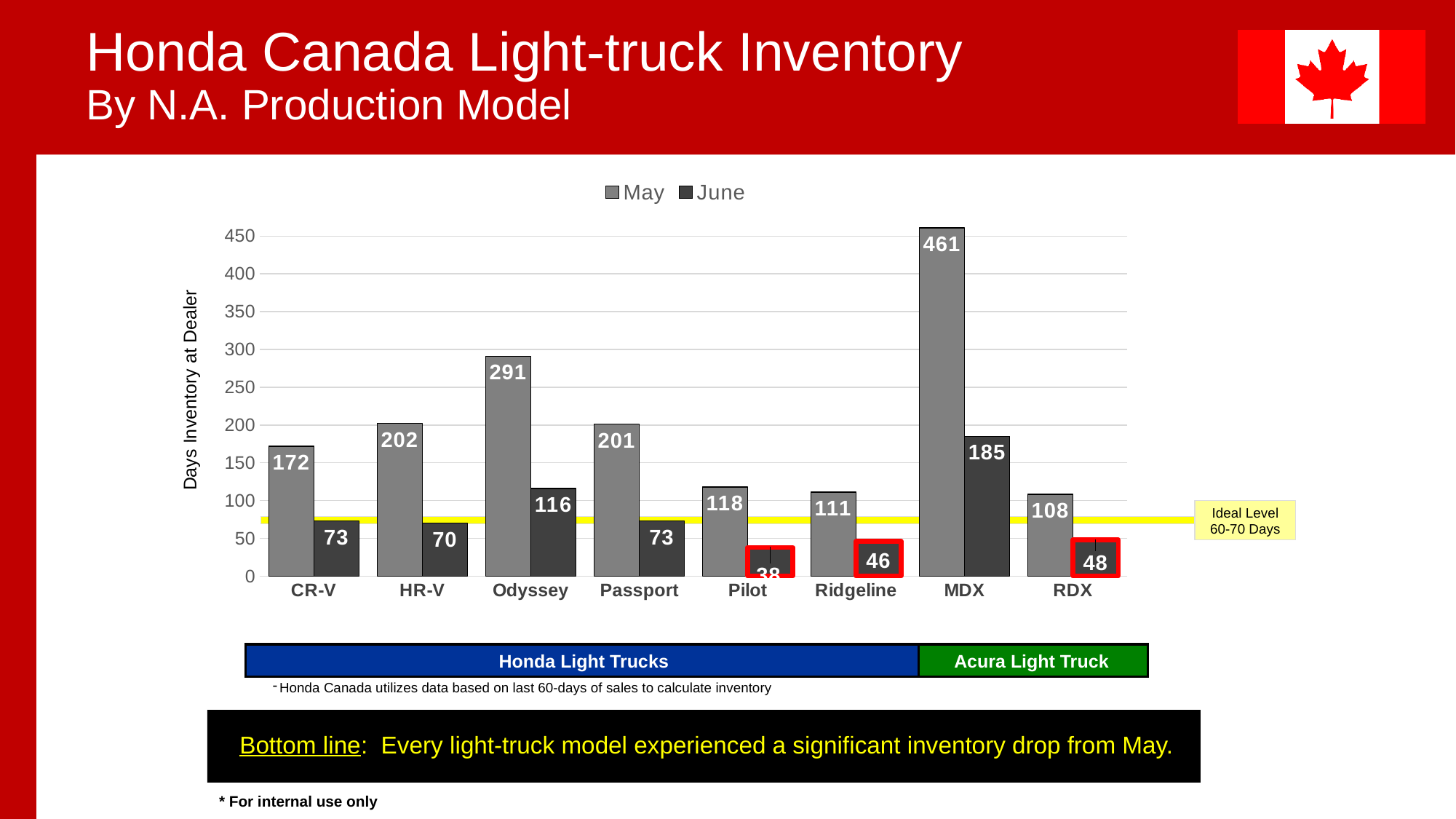
What is the June days inventory value for the MDX? 185 What is the June days inventory value for the Ridgeline? 46 Which model has the lowest May days inventory? RDX Which is larger, the June value for the Odyssey or the June value for the Passport? Odyssey Is the May value for the HR-V greater or less than 150? greater What is the difference between the May and June values for the CR-V? 99 Which model has the highest May days inventory? MDX How many series does the legend list? 2 What kind of chart is shown on the slide? bar chart What is the label on the vertical axis? Days Inventory at Dealer What is the May days inventory value for the Odyssey? 291 How many models are shown on the x axis? 8